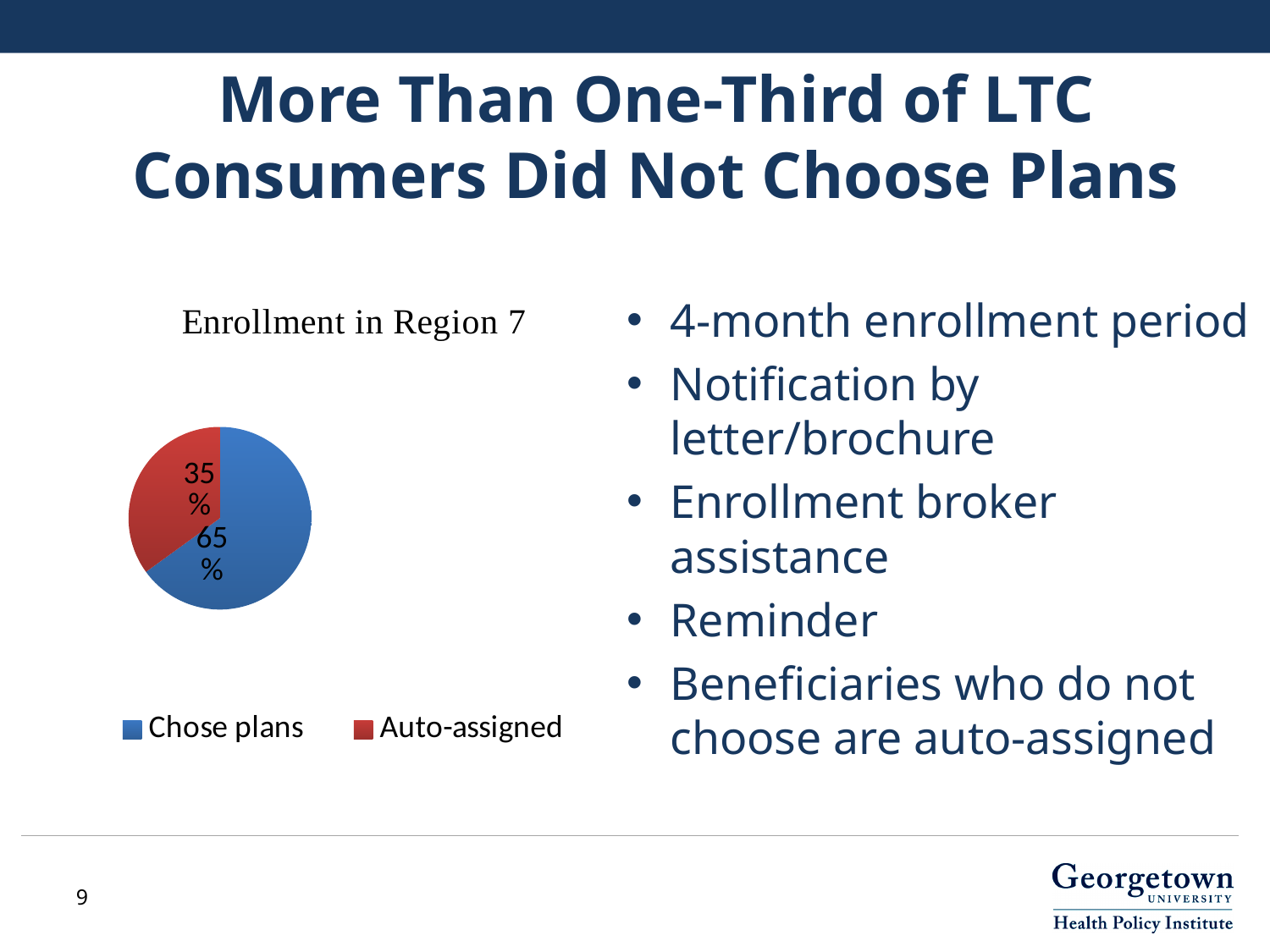
What share of the pie is labelled for Auto-assigned? 35% How many entries does the legend list? 2 What kind of chart is shown on the slide? pie chart Which is larger, the Chose plans slice or the Auto-assigned slice? Chose plans What colour is the Auto-assigned slice? red Which slice of the pie is the smallest? Auto-assigned What share of the pie is labelled for Chose plans? 65% How many slices does the pie chart have? 2 Which slice of the pie is the largest? Chose plans What is the share of the pie for Chose plans? 65% What is the title of the chart? Enrollment in Region 7 What is the difference in percentage points between the Chose plans slice and the Auto-assigned slice? 30